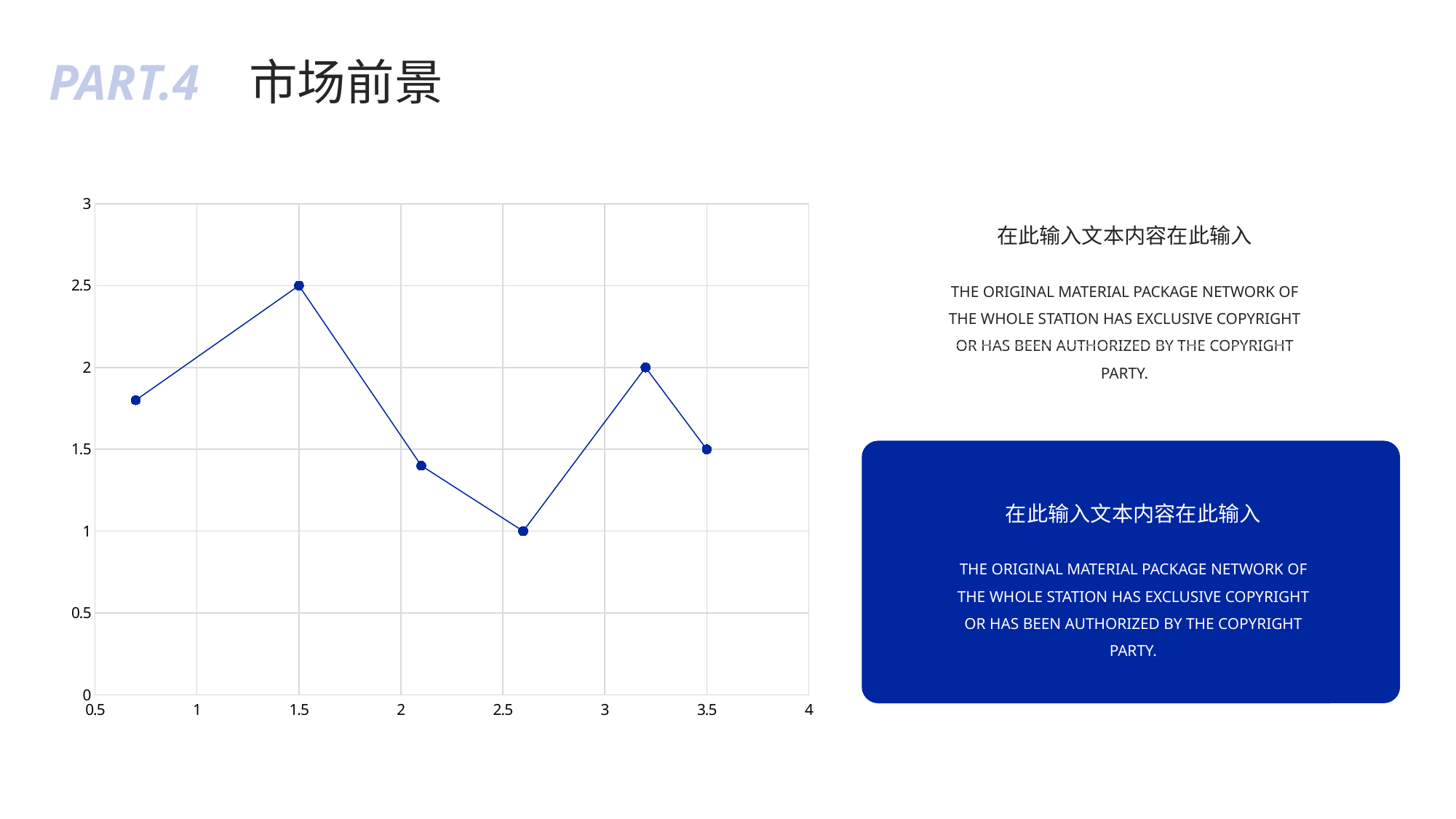
Is the y-value of the third point from the left greater or less than 1.5? less What is the y-value of the highest point on the chart? 2.5 What is the y-value of the lowest point on the chart? 1 What is the maximum value shown on the y-axis? 3 What is the range of the x-axis shown on the chart? 0.5 to 4 Is the y-value of the first (leftmost) point greater or less than 1.5? greater How many data points are plotted on the chart? 6 Do the y-values rise or fall between the second and fourth points from the left? fall What is the x-value of the highest point on the chart? 1.5 Is the y-value of the last (rightmost) point greater or less than 2? less Which is higher: the second point from the left or the fifth point from the left? the second point What kind of chart is shown on the slide? scatter chart with lines and markers